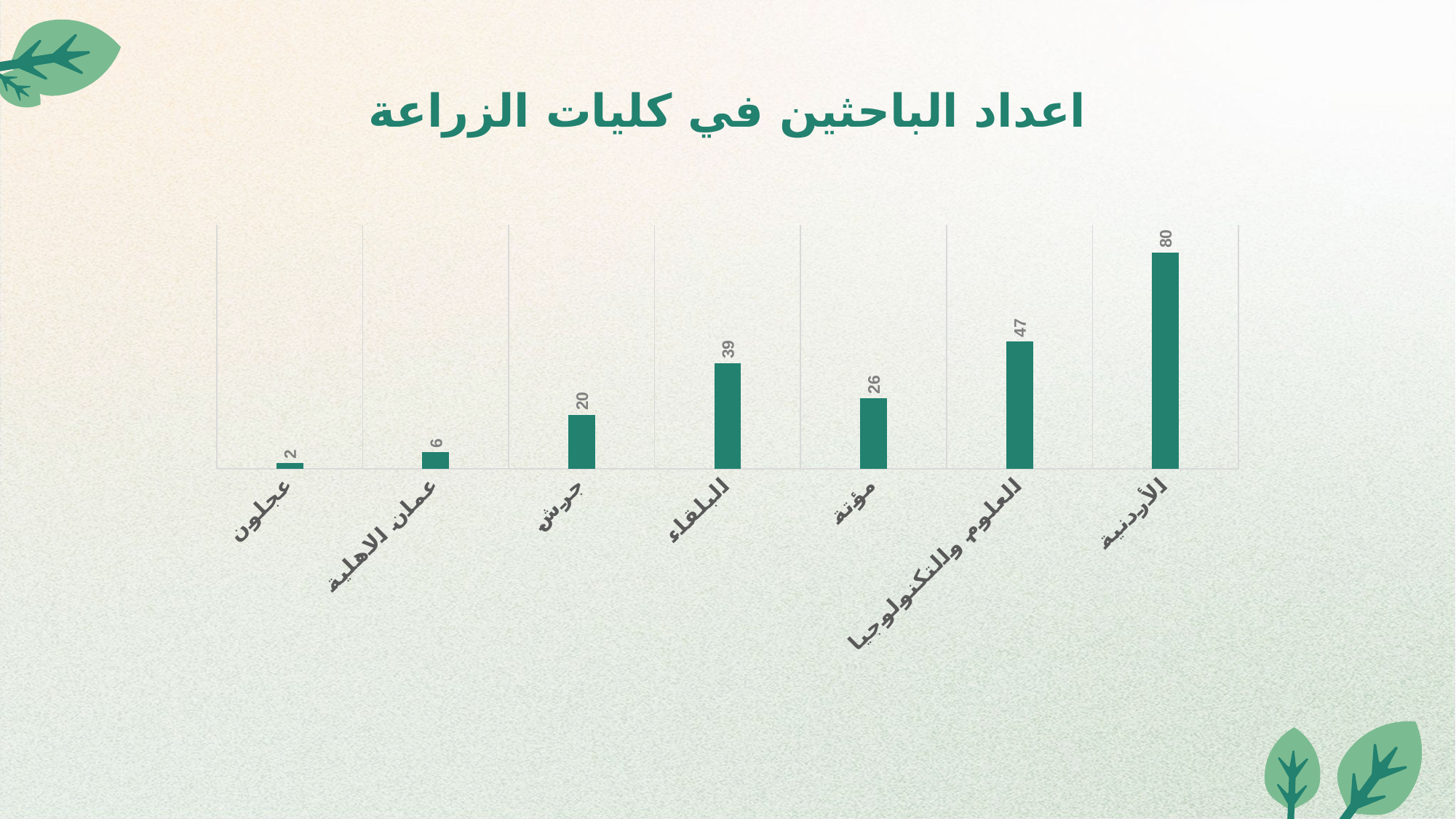
What kind of chart is shown on the slide? Bar chart Which category has the lowest value? عجلون What is the value for الأردنية? 80 What is the difference between the values for البلقاء and مؤتة? 13 What is the value for البلقاء? 39 What is the value for عجلون? 2 What is the value for مؤتة? 26 What is the title of the chart? اعداد الباحثين في كليات الزراعة Which category has the highest value? الأردنية Which is larger, the value for جرش or the value for عمان الاهلية? جرش How many categories are shown in the chart? 7 What is the difference between the values for الأردنية and العلوم والتكنولوجيا? 33